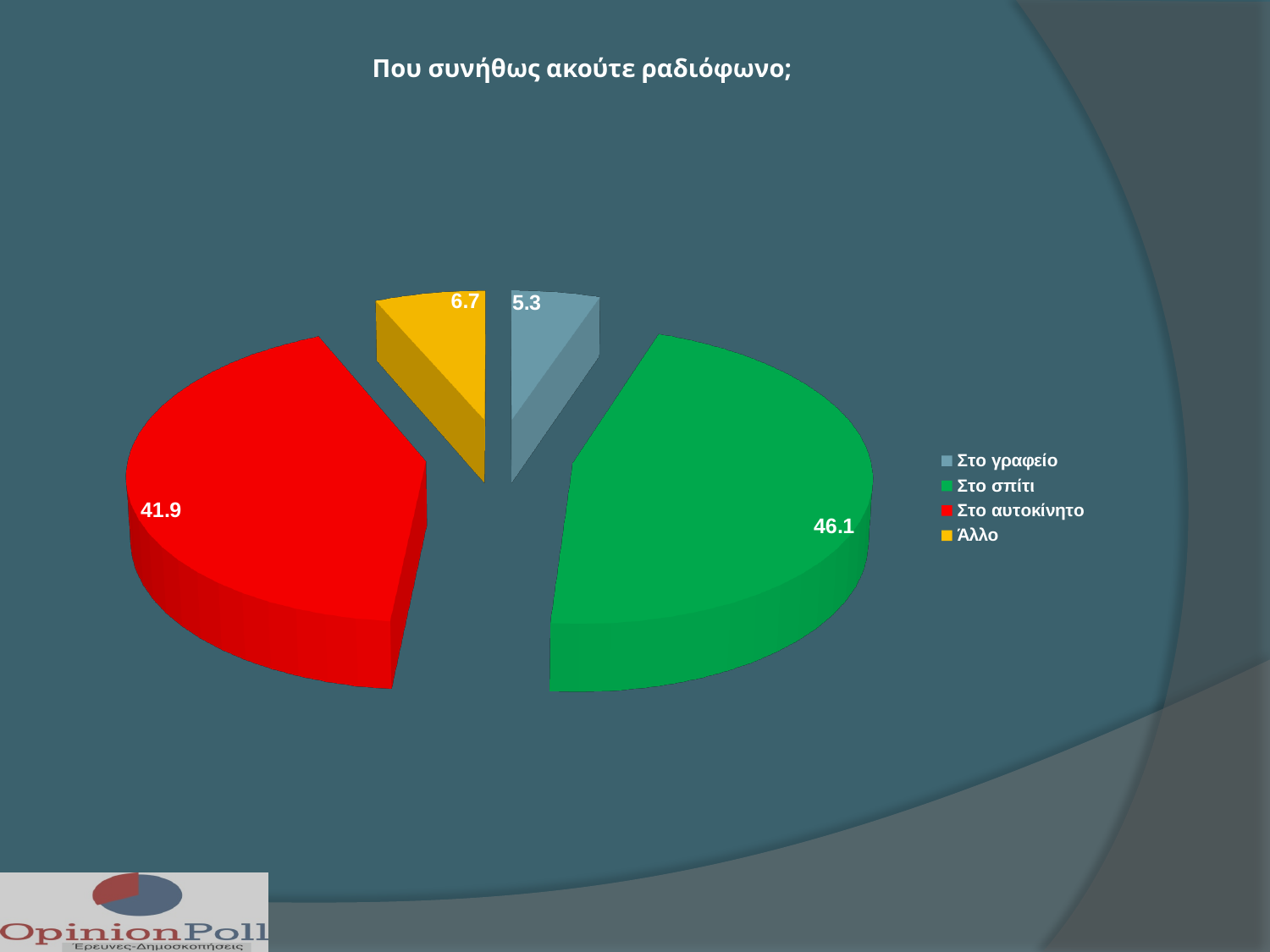
What is the value for Άλλο? 6.7 What is the value for Στο σπίτι? 46.1 What is the difference between the values for Στο σπίτι and Στο αυτοκίνητο? 4.2 Which category has the smallest slice? Στο γραφείο How many slices does the pie chart have? 4 Which category has the largest slice? Στο σπίτι What is the title of the chart? Που συνήθως ακούτε ραδιόφωνο; What is the value for Στο γραφείο? 5.3 What is the value for Στο αυτοκίνητο? 41.9 Which is larger, the value for Άλλο or the value for Στο γραφείο? Άλλο What type of chart is shown on the slide? Pie chart What colour is the slice for Στο αυτοκίνητο? Red